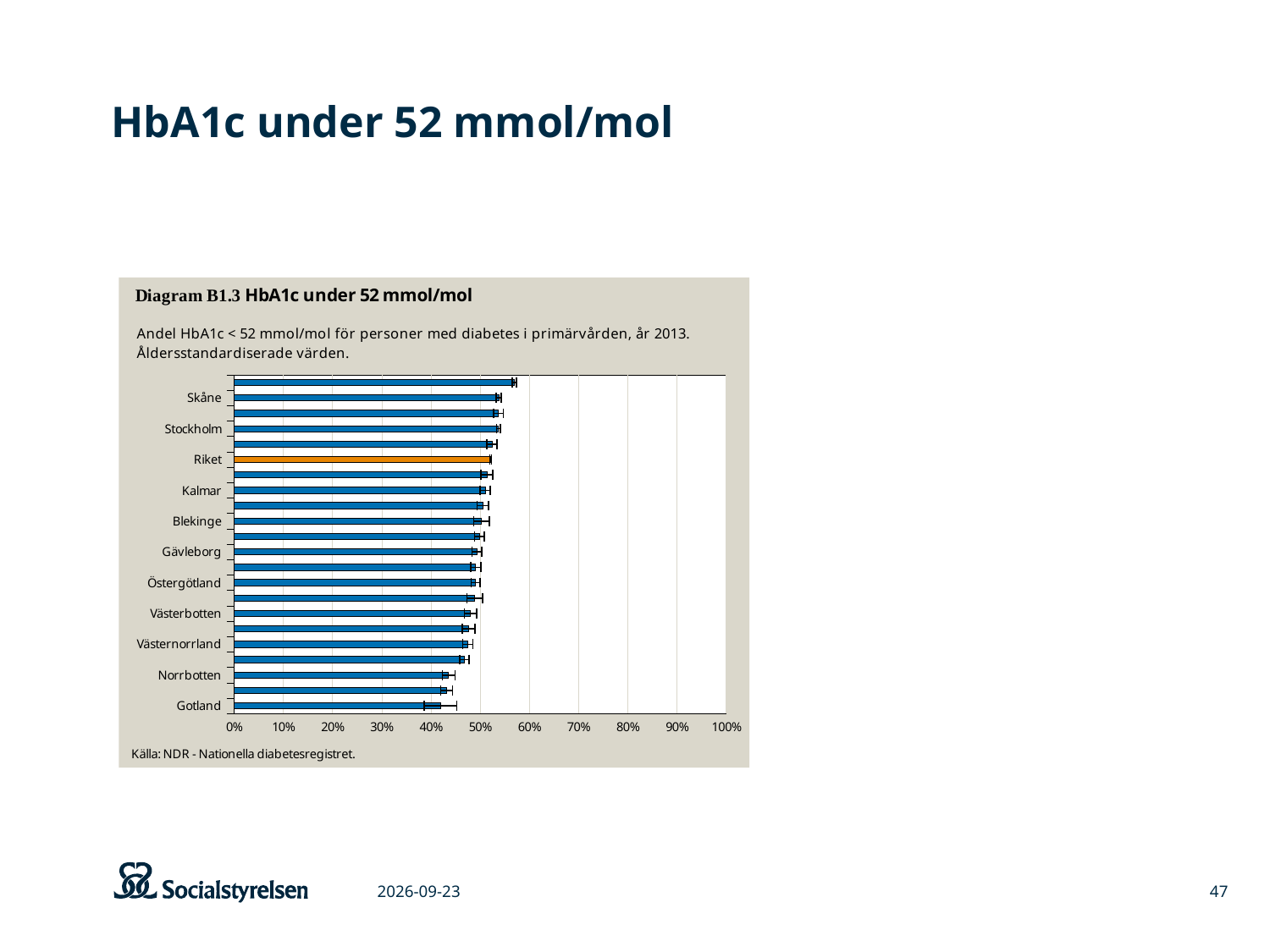
Is the value for Riket greater or less than 60%? less Are the bars ordered from highest at the top to lowest at the bottom? yes Which has the higher value, Norrbotten or Stockholm? Stockholm Which bar is coloured orange instead of blue? Riket Which has the higher value, Skåne or Gotland? Skåne Is the value for Gotland greater or less than 50%? less Is the value for Norrbotten greater or less than 50%? less What type of chart is shown on the slide? bar chart Among the regions labelled on the y axis, which has the lowest value? Gotland